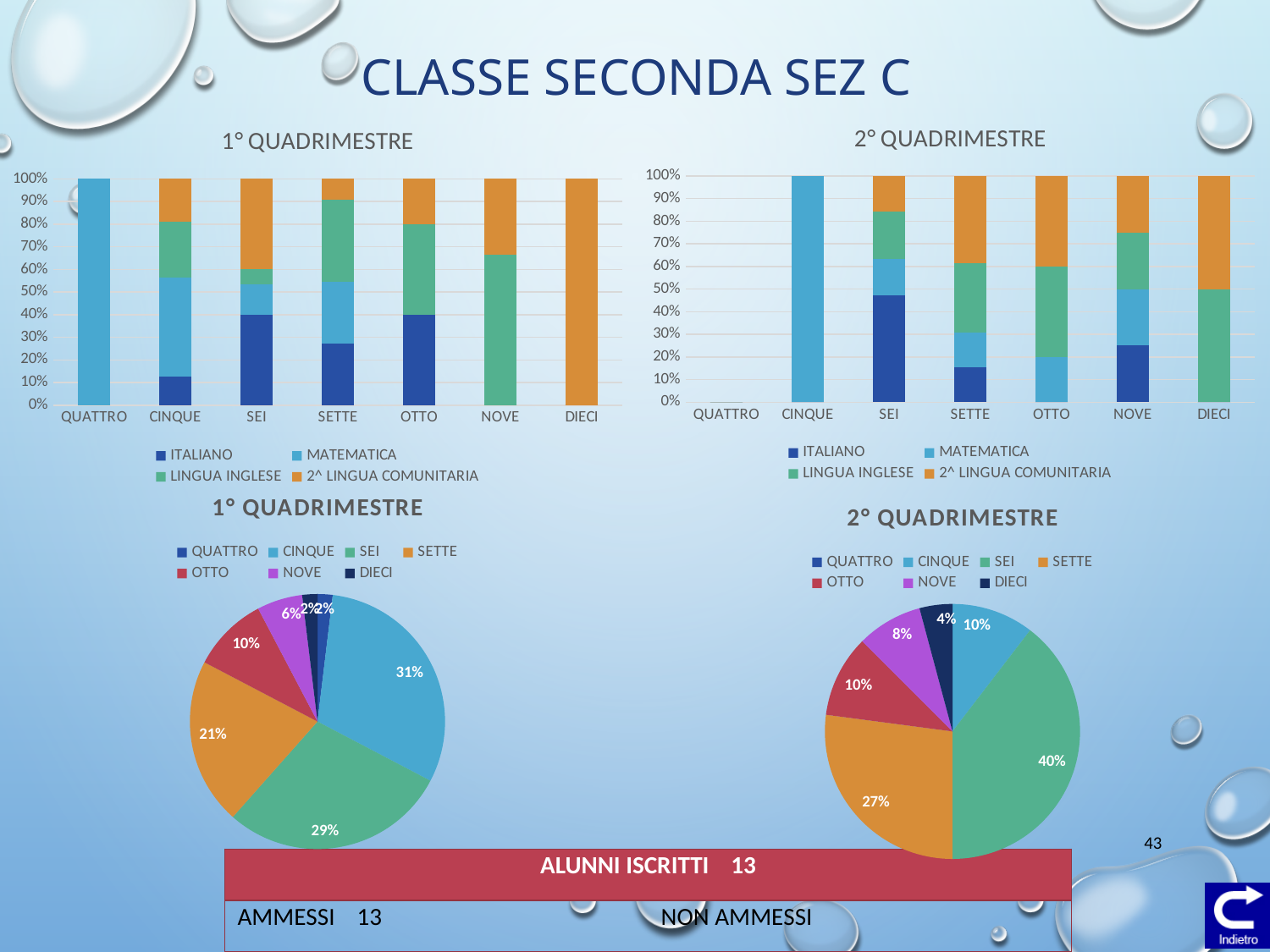
In the bottom-right pie chart (2° QUADRIMESTRE), what is the difference between the SEI share and the SETTE share? 13% In the bottom-right pie chart (2° QUADRIMESTRE), what share does NOVE have? 8% In the bottom-right pie chart (2° QUADRIMESTRE), which category has the largest slice? SEI In the bottom-left pie chart (1° QUADRIMESTRE), which category has the largest slice? CINQUE In the bottom-left pie chart (1° QUADRIMESTRE), what share does CINQUE have? 31% In the bottom-left pie chart (1° QUADRIMESTRE), which is larger, the share for SEI or the share for OTTO? SEI In the bottom-left pie chart (1° QUADRIMESTRE), what share does SETTE have? 21% How many series does the legend of the top-left stacked bar chart (1° QUADRIMESTRE) list? 4 In the bottom-right pie chart (2° QUADRIMESTRE), what share does SEI have? 40% In the top-left stacked bar chart (1° QUADRIMESTRE), is the LINGUA INGLESE portion of the NOVE bar greater or less than 50%? greater What kind of chart is the top-right chart titled 2° QUADRIMESTRE? Stacked bar chart How many categories are shown on the x axis of the top-right stacked bar chart (2° QUADRIMESTRE)? 7